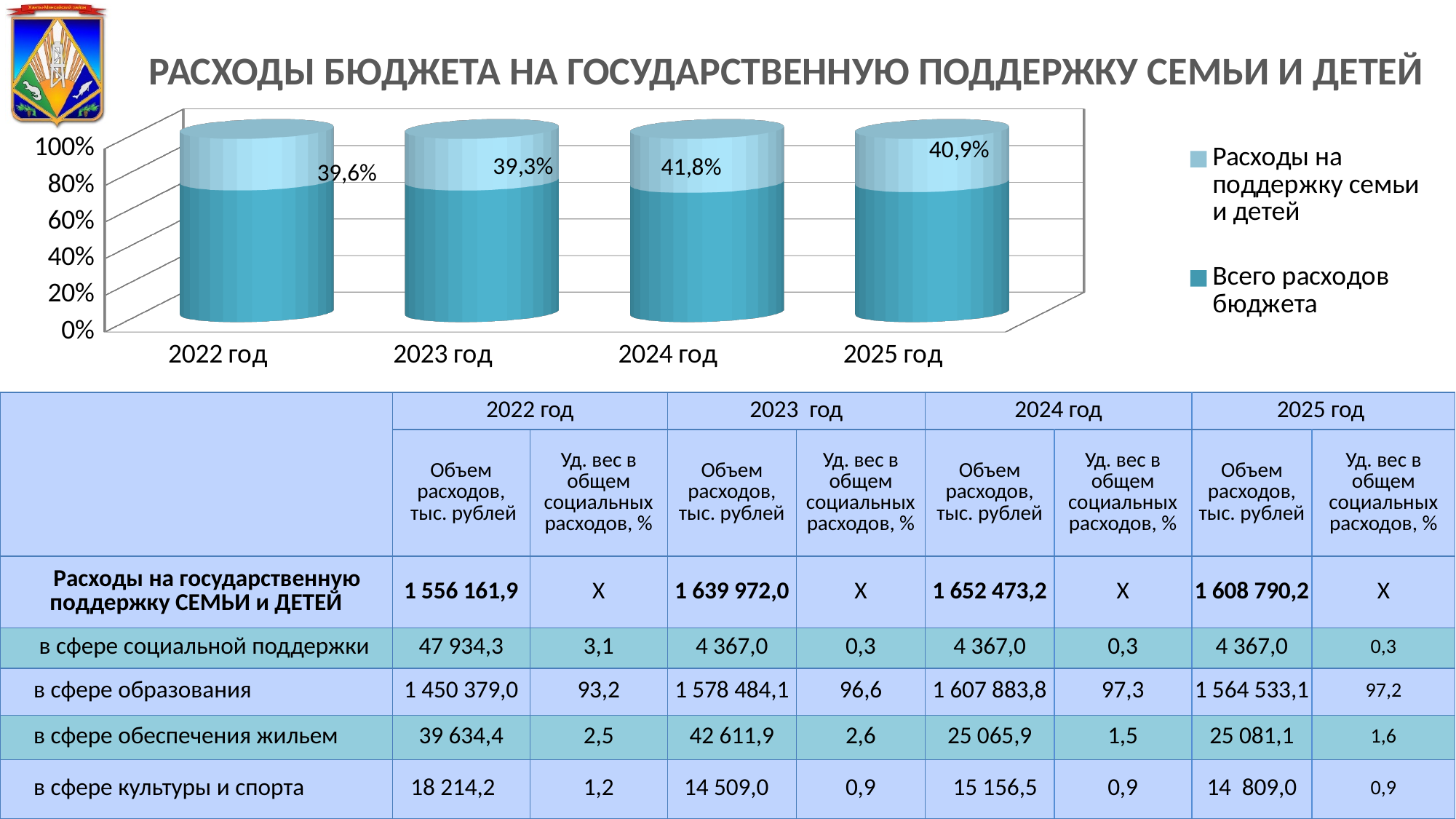
Which has the larger labelled value, 2022 год or 2025 год? 2025 год What value is labelled for 2023 год in the chart? 39,3% Which legend entry is shown with the darker colour in the chart? Всего расходов бюджета How many series does the chart legend list? 2 Which year has the highest labelled percentage in the chart? 2024 год What value is labelled for 2022 год in the chart? 39,6% What is the difference between the labelled values for 2024 год and 2023 год? 2,5% What value is labelled for 2025 год in the chart? 40,9% What value is labelled for 2024 год in the chart? 41,8% Which year has the lowest labelled percentage in the chart? 2023 год How many years are shown on the x axis of the chart? 4 What kind of chart is shown on the slide? bar chart